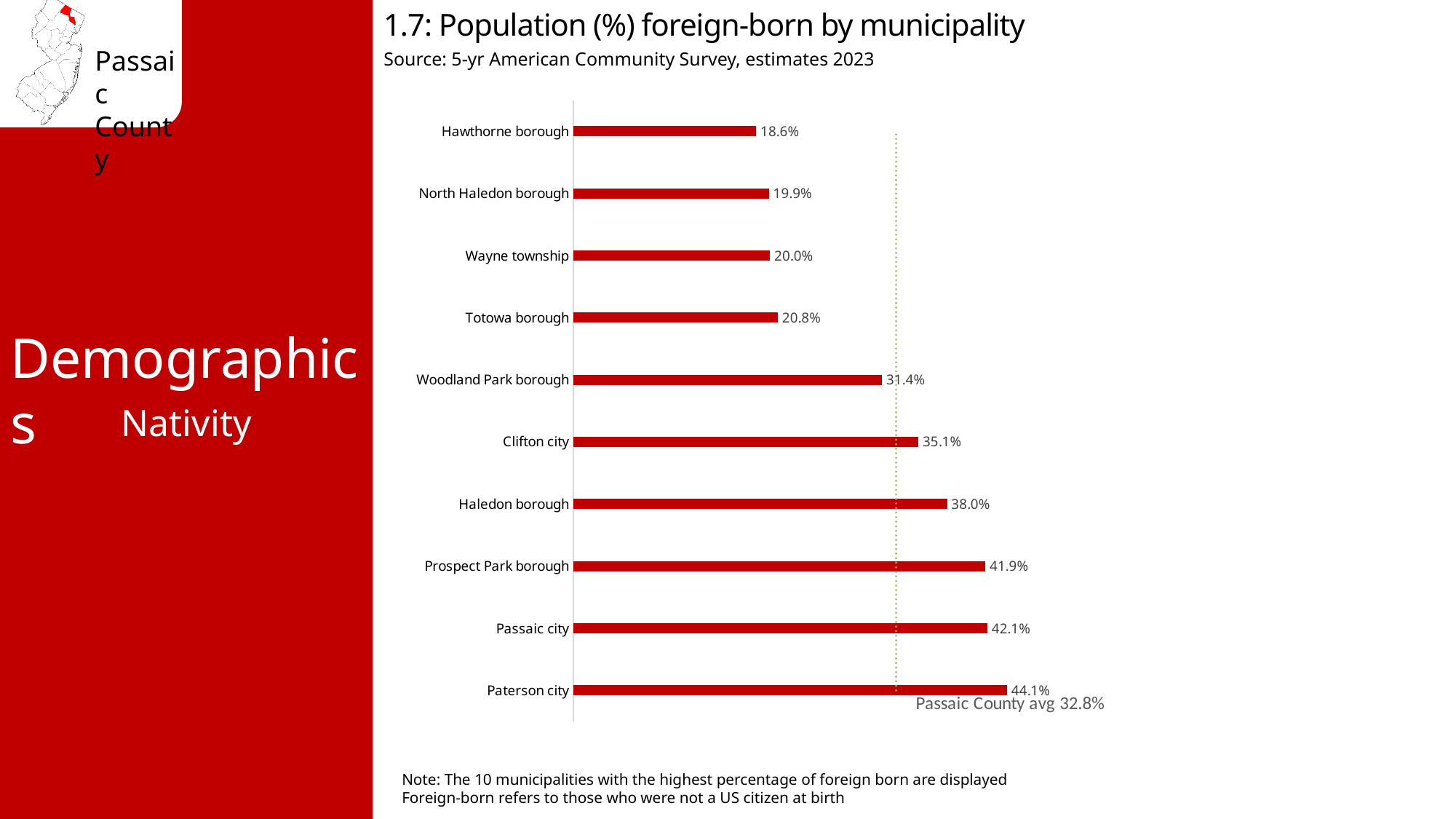
What is the foreign-born percentage shown for Clifton city? 35.1% What is the difference in foreign-born percentage between Haledon borough and Woodland Park borough? 6.6 percentage points Which municipality has the highest percentage of foreign-born population? Paterson city Which municipality has the lowest percentage of foreign-born population on the chart? Hawthorne borough What is the foreign-born percentage shown for Wayne township? 20.0% Which has a higher foreign-born percentage, Prospect Park borough or Clifton city? Prospect Park borough What is the source of the data shown in the chart? 5-yr American Community Survey, estimates 2023 How many municipalities are shown on the chart? 10 What percentage of the population is foreign-born in Paterson city? 44.1% What type of chart is used to show the foreign-born percentages? Bar chart What is the difference in foreign-born percentage between Paterson city and Hawthorne borough? 25.5 percentage points What is the Passaic County average foreign-born percentage indicated by the dotted line? 32.8%